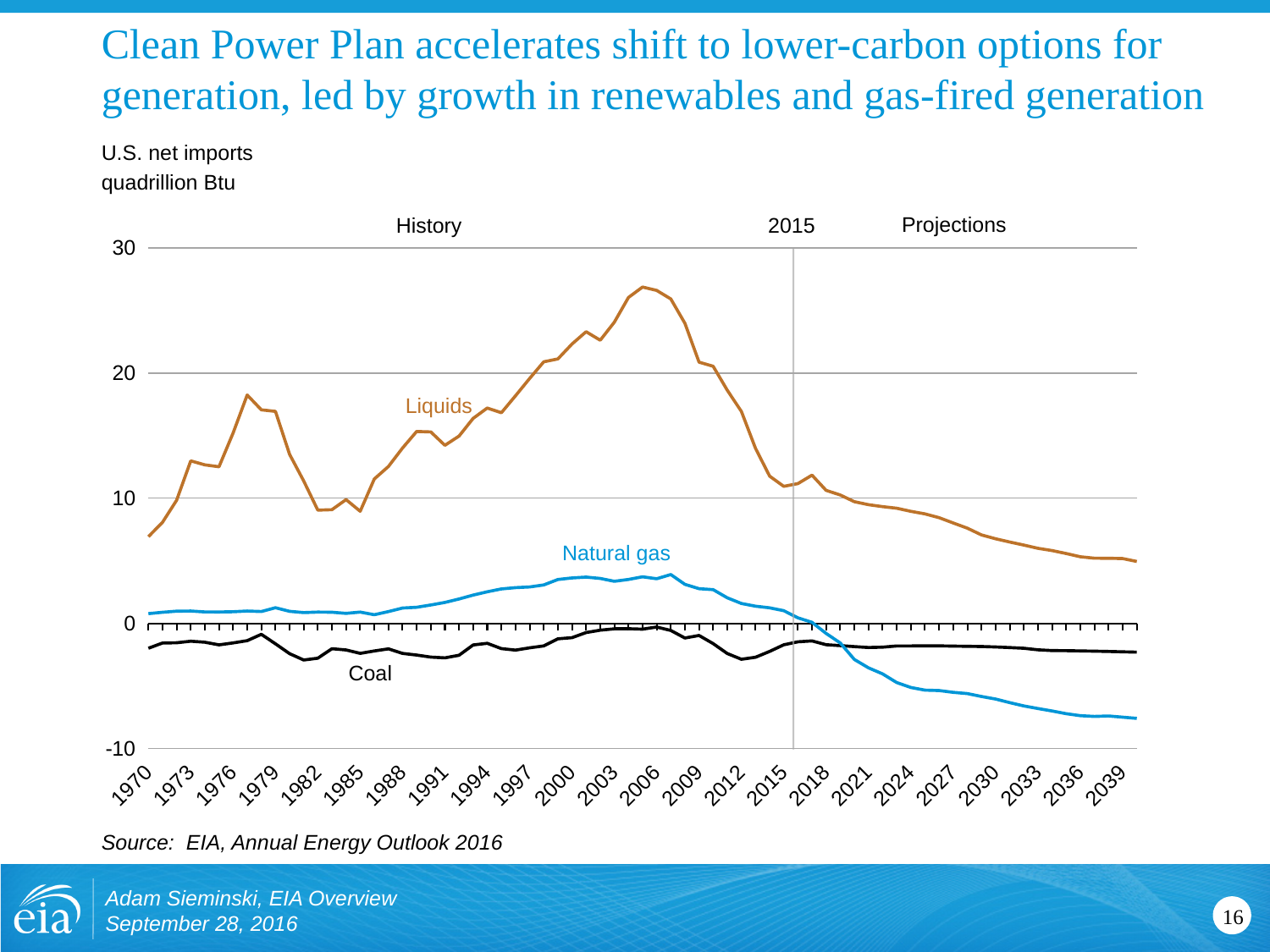
Is the value for Natural gas in 2039 greater or less than 0? less Do the values for Liquids rise or fall from 2015 to 2039? fall Is the value for Liquids in 2039 greater or less than 10? less Which series has the lowest value in 2039? Natural gas Which series has the highest value in 2006? Liquids What kind of chart is shown on the slide? line chart Which is larger in 2006, Liquids or Natural gas? Liquids Is the value for Natural gas in 2006 greater or less than 0? greater What unit is the y axis measured in? quadrillion Btu How many series are plotted on the chart? 3